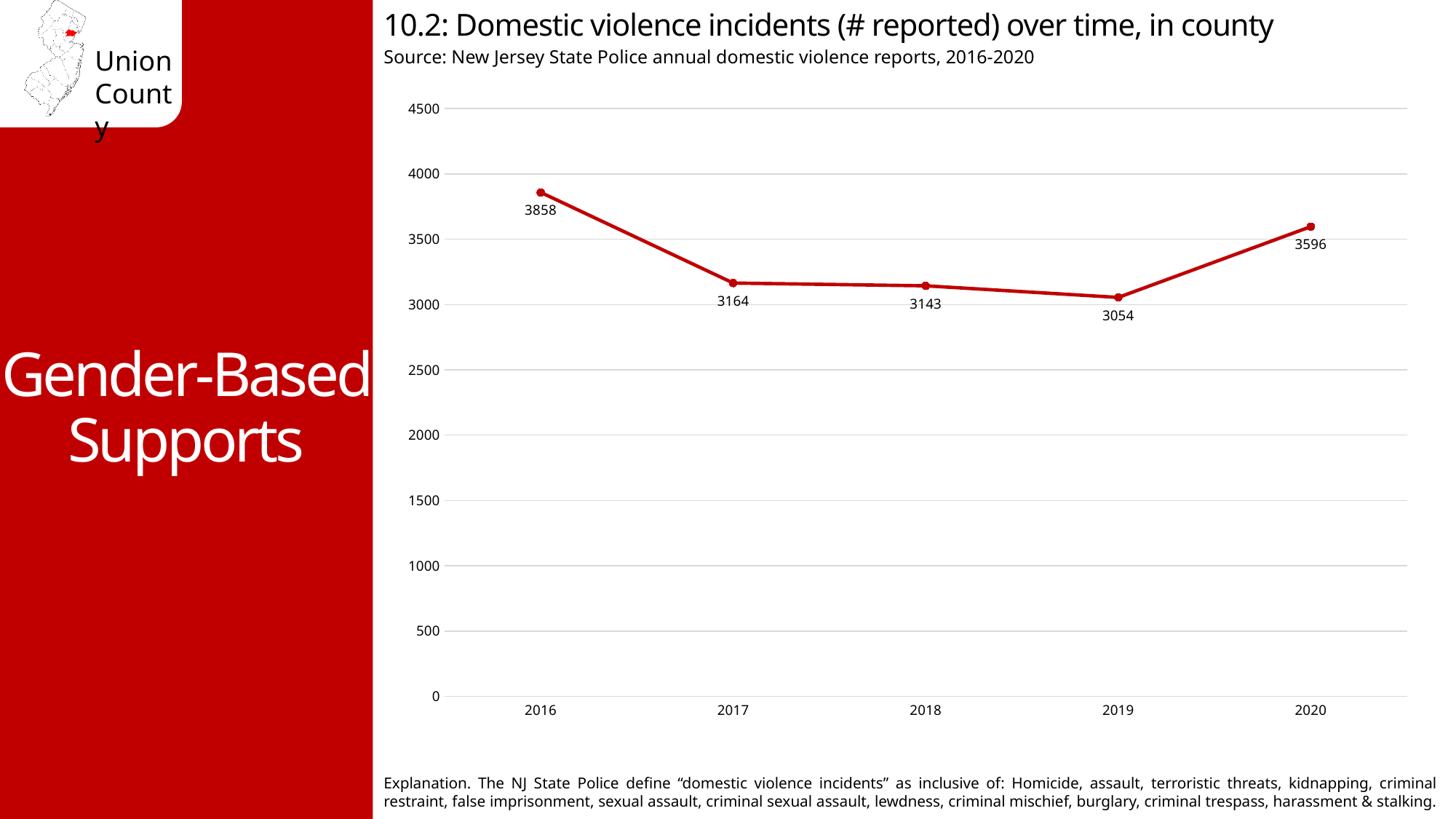
Is the value for 2018 greater or less than 3000? greater How many years are plotted on the chart? 5 How many domestic violence incidents were reported in 2016? 3858 What is the difference between the 2016 and 2017 values? 694 Which year has the lowest number of reported domestic violence incidents? 2019 Which year has a larger value, 2017 or 2018? 2017 Which year has the highest number of reported domestic violence incidents? 2016 What kind of chart is shown on the slide? line chart Do the values rise or fall from 2016 to 2019? fall What is the value for 2019? 3054 What is the value for 2020? 3596 What is the difference between the 2020 and 2019 values? 542